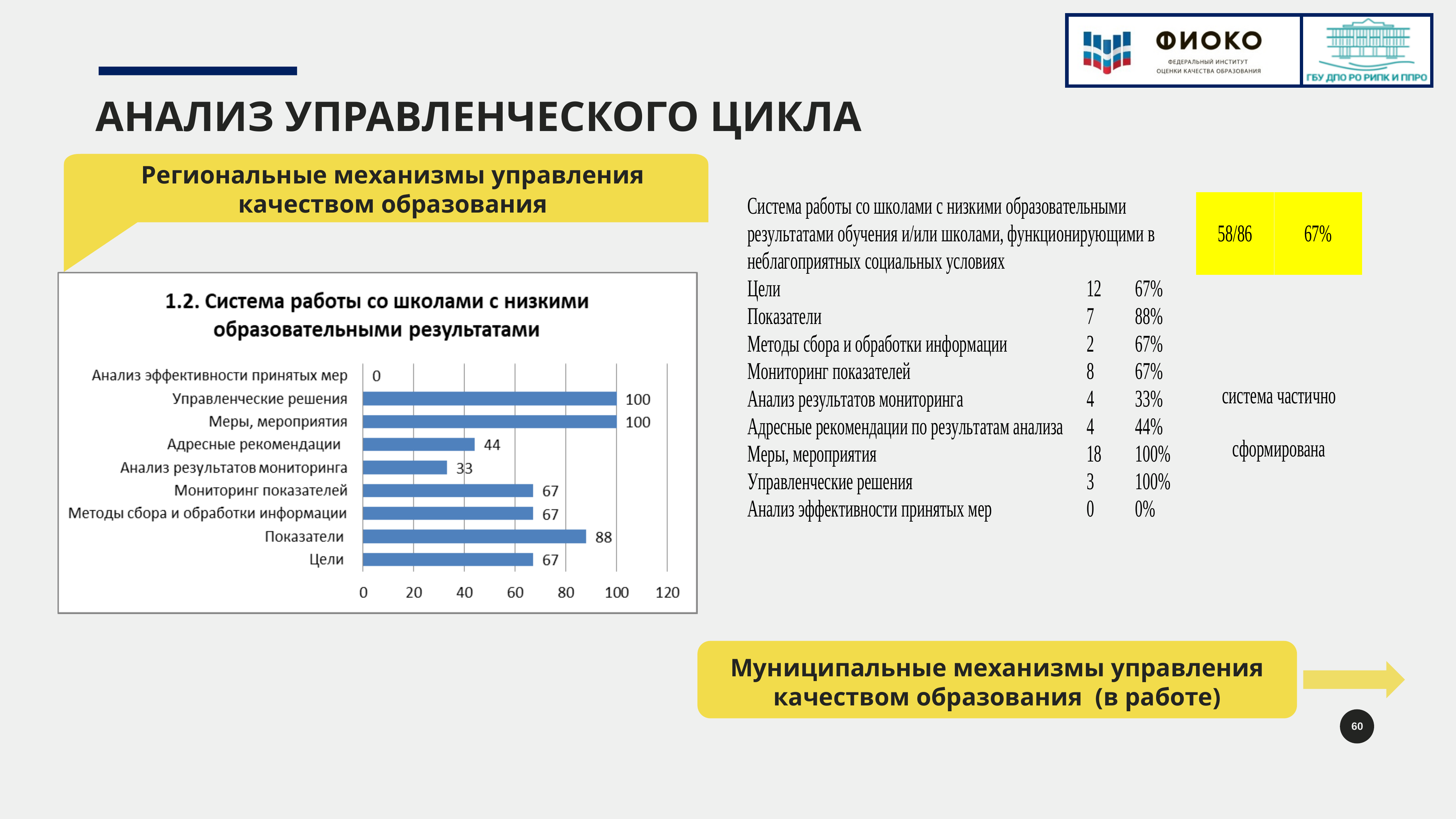
What is the value for Адресные рекомендации in the chart? 44 What kind of chart is shown on the slide? bar chart Which is larger: the value for Адресные рекомендации or the value for Анализ результатов мониторинга? Адресные рекомендации What is the difference between the values for Управленческие решения and Адресные рекомендации? 56 What is the title of the chart? 1.2. Система работы со школами с низкими образовательными результатами What is the difference between the values for Показатели and Цели? 21 How many categories are shown in the chart? 9 Which category has the lowest value in the chart? Анализ эффективности принятых мер What is the value for Цели in the chart? 67 What is the value for Показатели in the chart? 88 What is the highest tick value shown on the horizontal axis of the chart? 120 What is the value for Анализ результатов мониторинга in the chart? 33